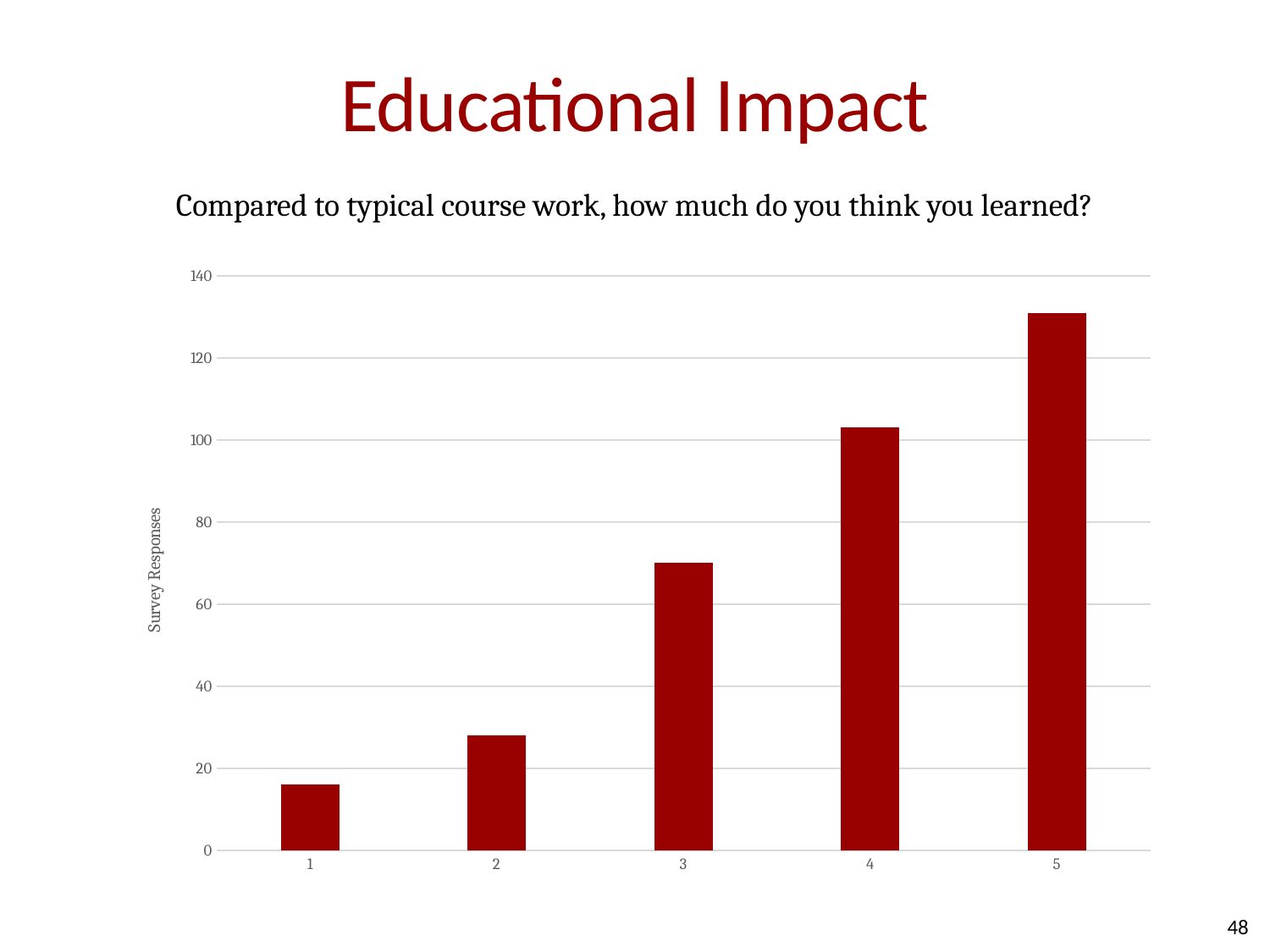
Is the value for category 1 greater or less than 20? less Is the value for category 2 greater or less than 40? less Is the value for category 3 greater or less than 60? greater Do the survey responses rise or fall as the rating goes from 1 to 5? rise Which category has the highest number of survey responses? 5 Which category has the lowest number of survey responses? 1 How many categories are shown on the x axis? 5 What kind of chart is shown on the slide? bar chart Which has more survey responses, category 3 or category 4? 4 What is the label on the y axis? Survey Responses